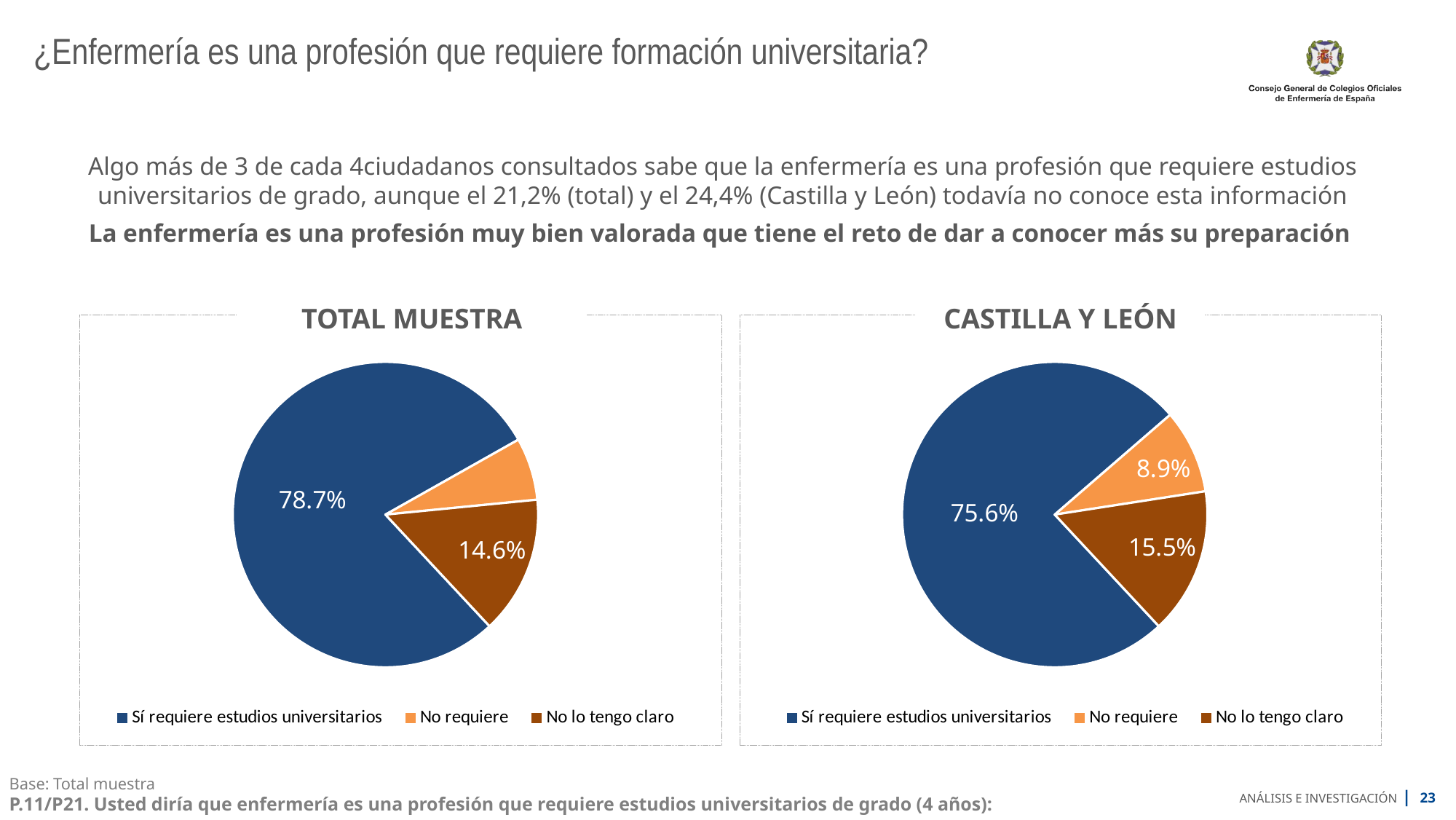
In the CASTILLA Y LEÓN chart, what percentage is shown for 'No requiere'? 8.9% In the TOTAL MUESTRA chart, what is the difference between 'Sí requiere estudios universitarios' and 'No lo tengo claro'? 64.1% In the TOTAL MUESTRA chart, what percentage is shown for 'No lo tengo claro'? 14.6% In the TOTAL MUESTRA chart, which category has the smallest slice? No requiere In the CASTILLA Y LEÓN chart, what is the difference between 'No lo tengo claro' and 'No requiere'? 6.6% In the TOTAL MUESTRA chart, what colour is the 'No requiere' slice? Orange In the TOTAL MUESTRA chart, what percentage is shown for 'Sí requiere estudios universitarios'? 78.7% Which chart shows a larger share for 'Sí requiere estudios universitarios', TOTAL MUESTRA or CASTILLA Y LEÓN? TOTAL MUESTRA What type of chart is the TOTAL MUESTRA chart? Pie chart In the CASTILLA Y LEÓN chart, what percentage is shown for 'No lo tengo claro'? 15.5% How many categories does the legend of the CASTILLA Y LEÓN chart list? 3 In the CASTILLA Y LEÓN chart, which category has the largest slice? Sí requiere estudios universitarios